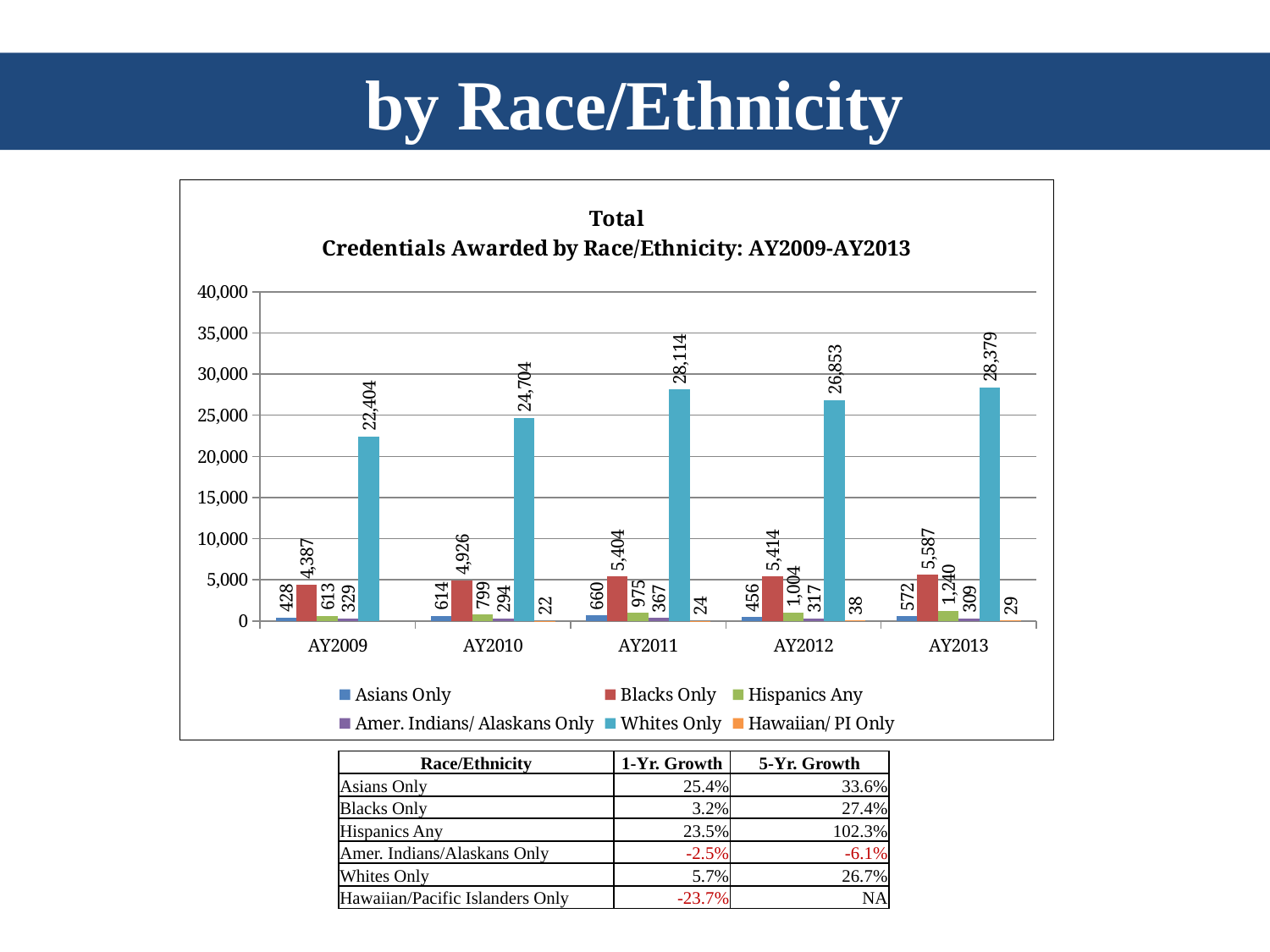
What is the value for Blacks Only in AY2011? 5,404 What kind of chart is shown? bar chart What is the value for Whites Only in AY2013? 28,379 What is the value for Hispanics Any in AY2013? 1,240 In which academic year is the Whites Only value lowest? AY2009 Which is larger: Asians Only in AY2011 or Asians Only in AY2012? Asians Only in AY2011 How many academic years are shown on the x axis? 5 What is the difference between the Whites Only values in AY2011 and AY2012? 1,261 How many series does the legend list? 6 What is the value for Hawaiian/PI Only in AY2012? 38 In which academic year is the Whites Only value highest? AY2013 Is the value for Whites Only in AY2010 greater or less than 25,000? less